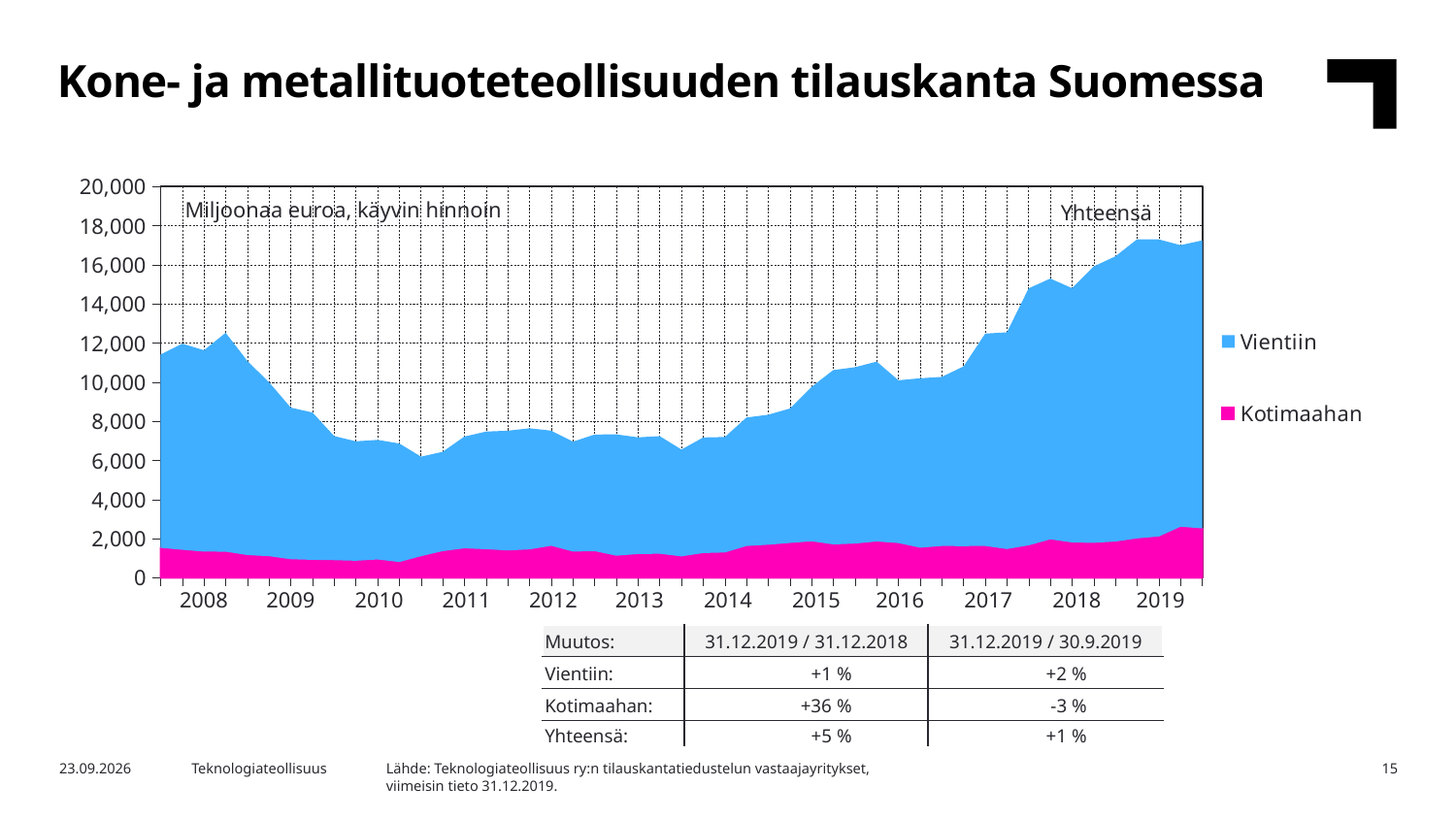
Is the total (Yhteensä) value in 2010 greater or less than 8,000? less Does the total order backlog rise or fall between 2016 and 2019? rise What kind of chart is shown on the slide? Stacked area chart Is the Kotimaahan value at the end of 2019 greater or less than 2,000? greater Does the total order backlog rise or fall between 2008 and 2010? fall Is the Kotimaahan value in 2010 greater or less than 2,000? less Which series is larger throughout the chart, Vientiin or Kotimaahan? Vientiin Which two series are listed in the chart legend? Vientiin and Kotimaahan How many years are labelled on the x axis of the chart? 12 How many series does the chart legend list? 2 What unit is stated in the chart's subtitle? Miljoonaa euroa, käyvin hinnoin